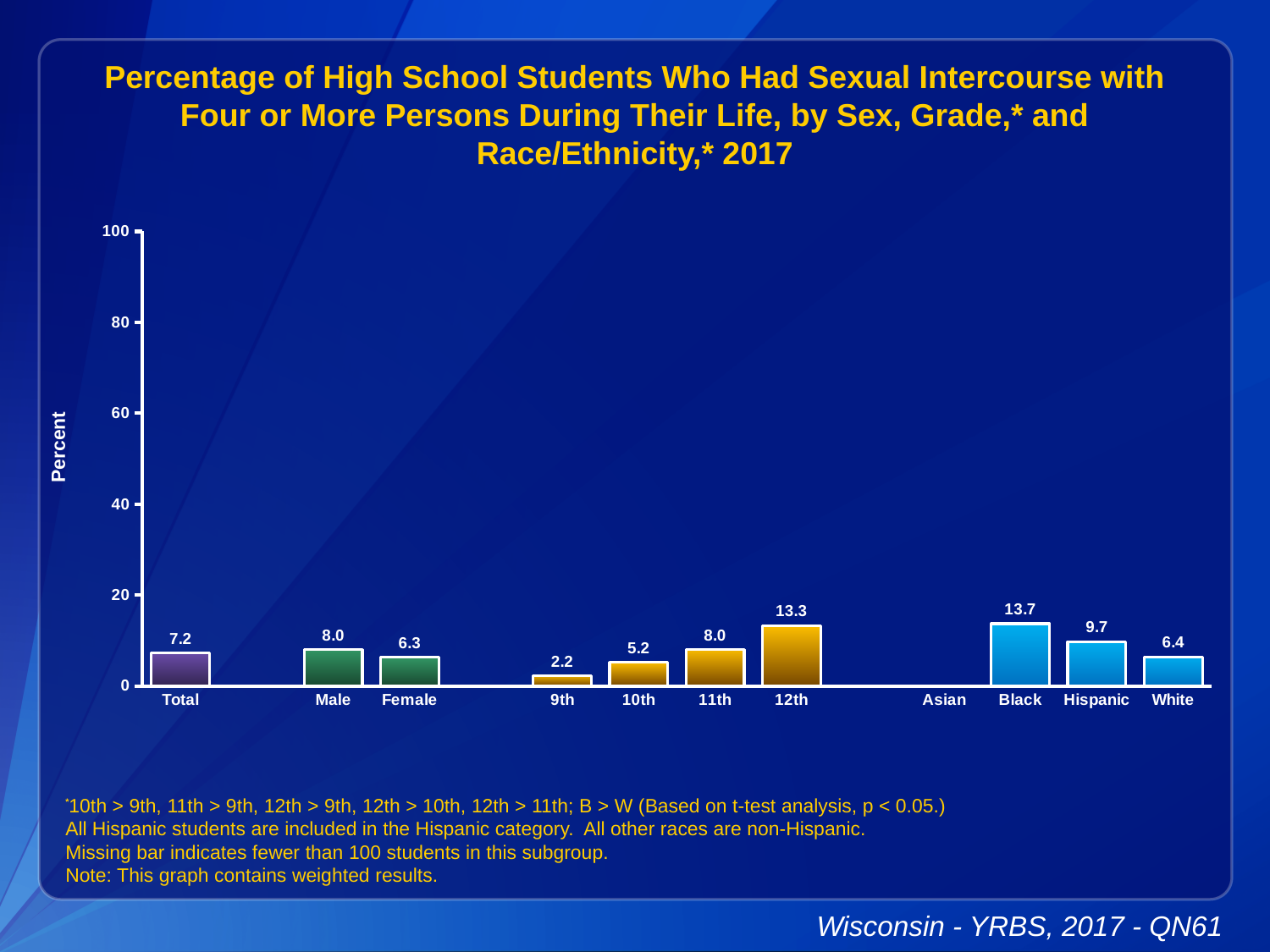
What kind of chart is shown on the slide? bar chart Which category with a bar has the lowest value? 9th Do the values rise or fall from 9th grade to 12th grade? rise What is the value for Female? 6.3 What is the value for Hispanic? 9.7 Which category has the highest value? Black Is the value for 12th grade greater or less than 20? less Which category has no bar shown? Asian What is the value for 9th grade? 2.2 What is the difference between the values for 12th and 9th grade? 11.1 What is the value for Total? 7.2 Which is larger, the value for Male or the value for Female? Male